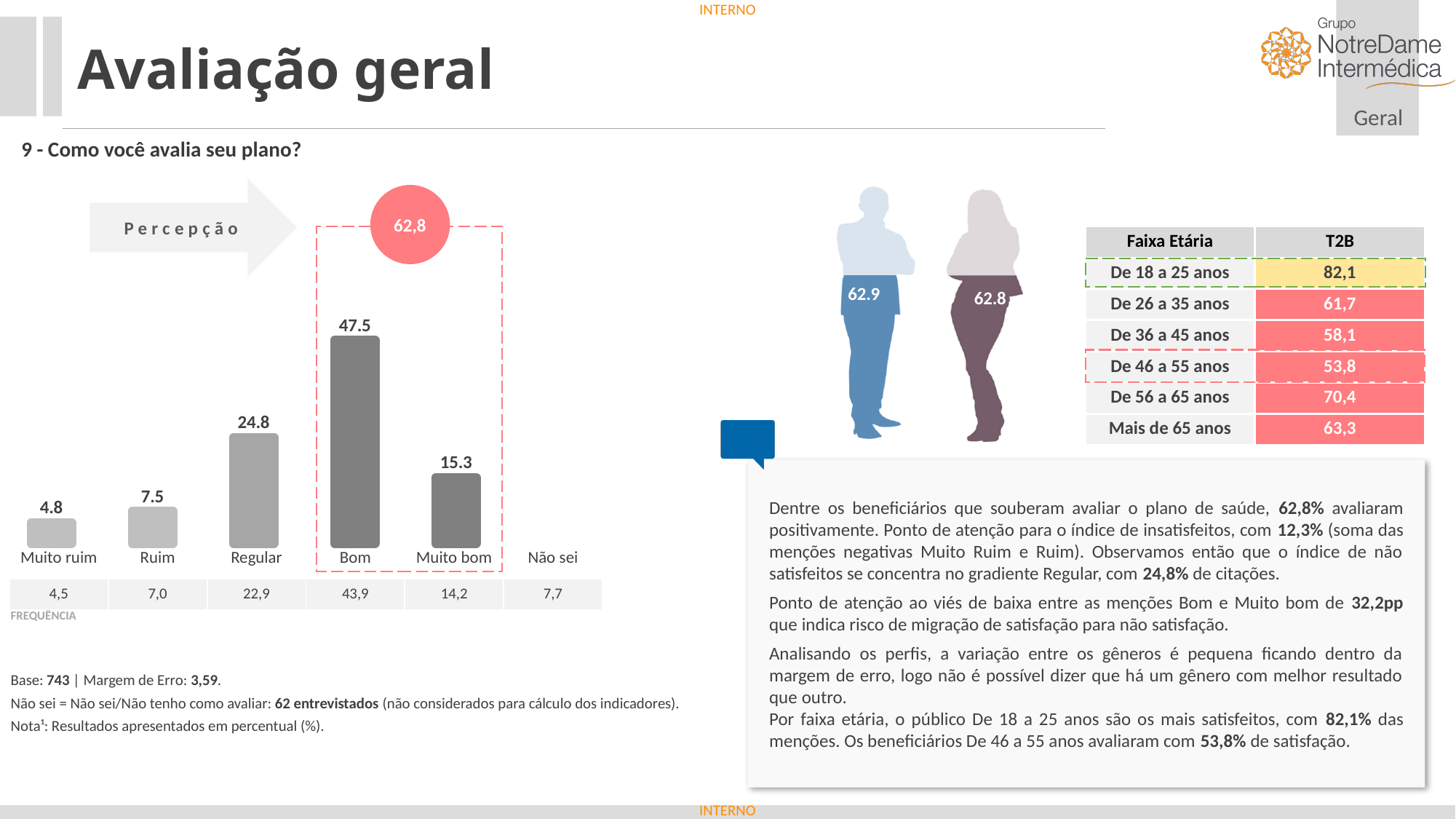
What is the difference between the Bom and Muito bom values in the bar chart? 32.2 What is the value shown for the Bom bar in the bar chart? 47.5 How many category labels are shown along the x axis of the bar chart? 6 What is the value shown for the Muito ruim bar in the bar chart? 4.8 What is the combined value of the Muito ruim and Ruim bars in the bar chart? 12.3 What kind of chart is used to show the plan evaluation? Bar chart Which category has the lowest labelled bar in the bar chart? Muito ruim What value is shown in the red circle above the dashed box around Bom and Muito bom? 62,8 What is the value shown for the Muito bom bar in the bar chart? 15.3 Which category has the highest bar in the bar chart? Bom Which is larger in the bar chart, Regular or Ruim? Regular What is the value shown for the Regular bar in the bar chart? 24.8